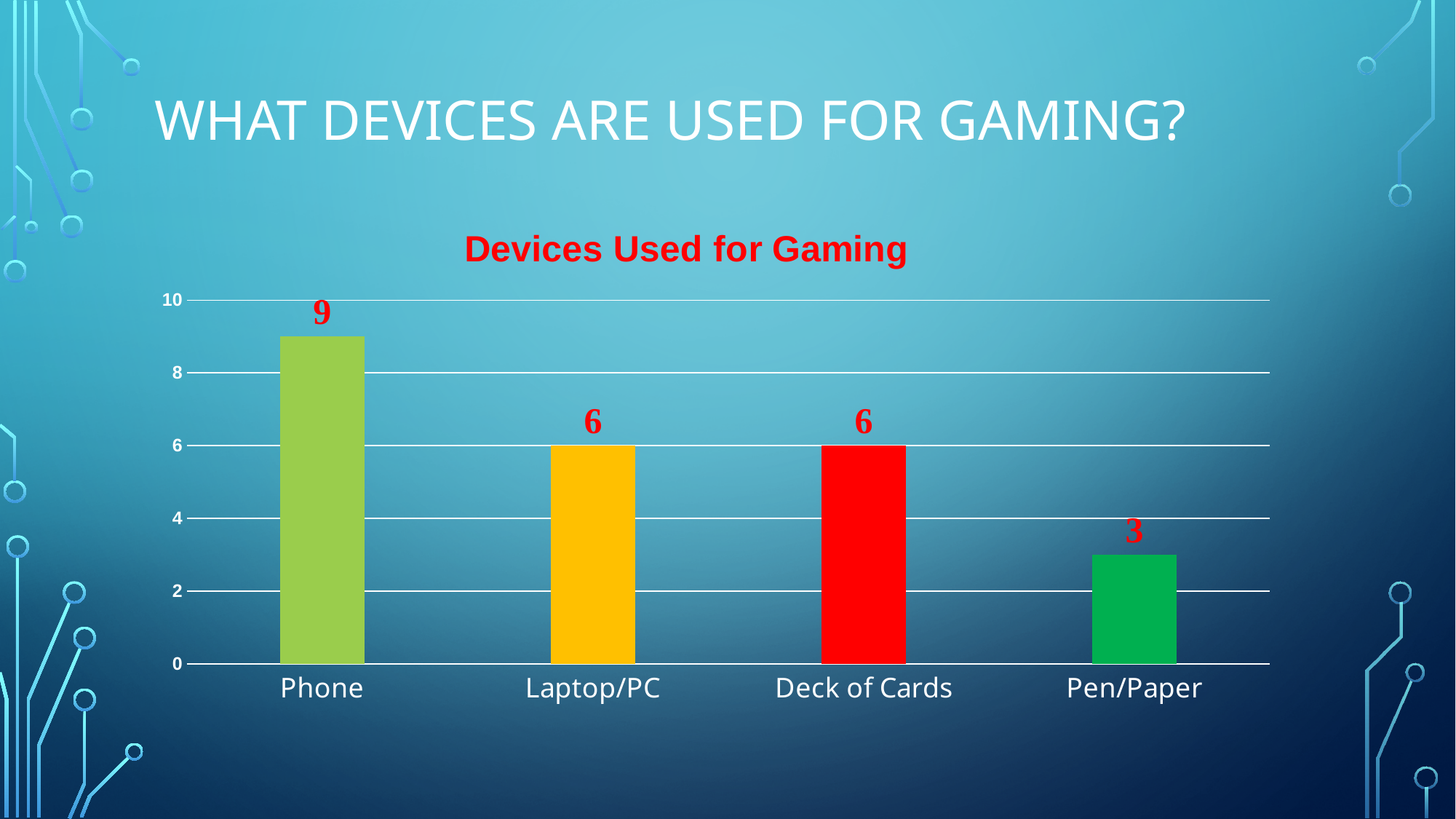
What is the difference between the values for Phone and Pen/Paper? 6 What is the value for Phone? 9 Is the value for Phone greater or less than 8? greater What kind of chart is shown on the slide? Bar chart Which category has the highest value? Phone What is the difference between the values for Phone and Deck of Cards? 3 How many categories are shown in the chart? 4 What is the title of the chart? Devices Used for Gaming What is the value for Pen/Paper? 3 Which is larger, the value for Deck of Cards or the value for Pen/Paper? Deck of Cards Which category has the lowest value? Pen/Paper What is the value for Laptop/PC? 6